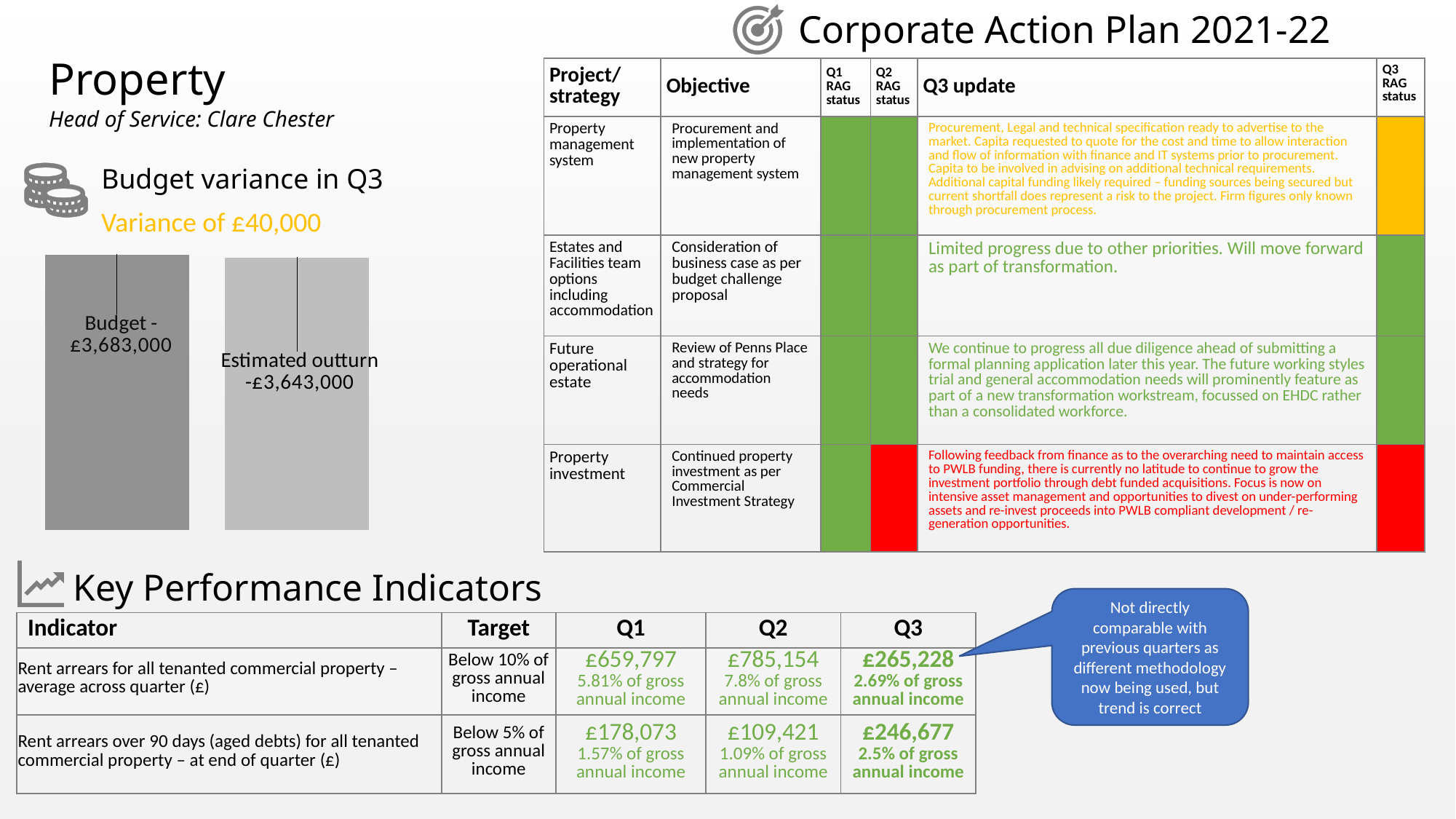
Do the values fall or rise from the Budget bar to the Estimated outturn bar in the Budget variance in Q3 chart? Fall What type of chart is used to show the Budget variance in Q3? Bar chart What is the title of the chart on the left of the slide? Budget variance in Q3 What is the value of the Budget bar in the Budget variance in Q3 chart? £3,683,000 Which bar is taller in the Budget variance in Q3 chart, Budget or Estimated outturn? Budget Which category has the lowest value in the Budget variance in Q3 chart? Estimated outturn Which category has the highest value in the Budget variance in Q3 chart? Budget How many bars are shown in the Budget variance in Q3 chart? 2 What is the difference between the Budget and Estimated outturn values in the Budget variance in Q3 chart? £40,000 What is the value of the Estimated outturn bar in the Budget variance in Q3 chart? £3,643,000 What variance amount is stated above the Budget variance in Q3 chart? Variance of £40,000